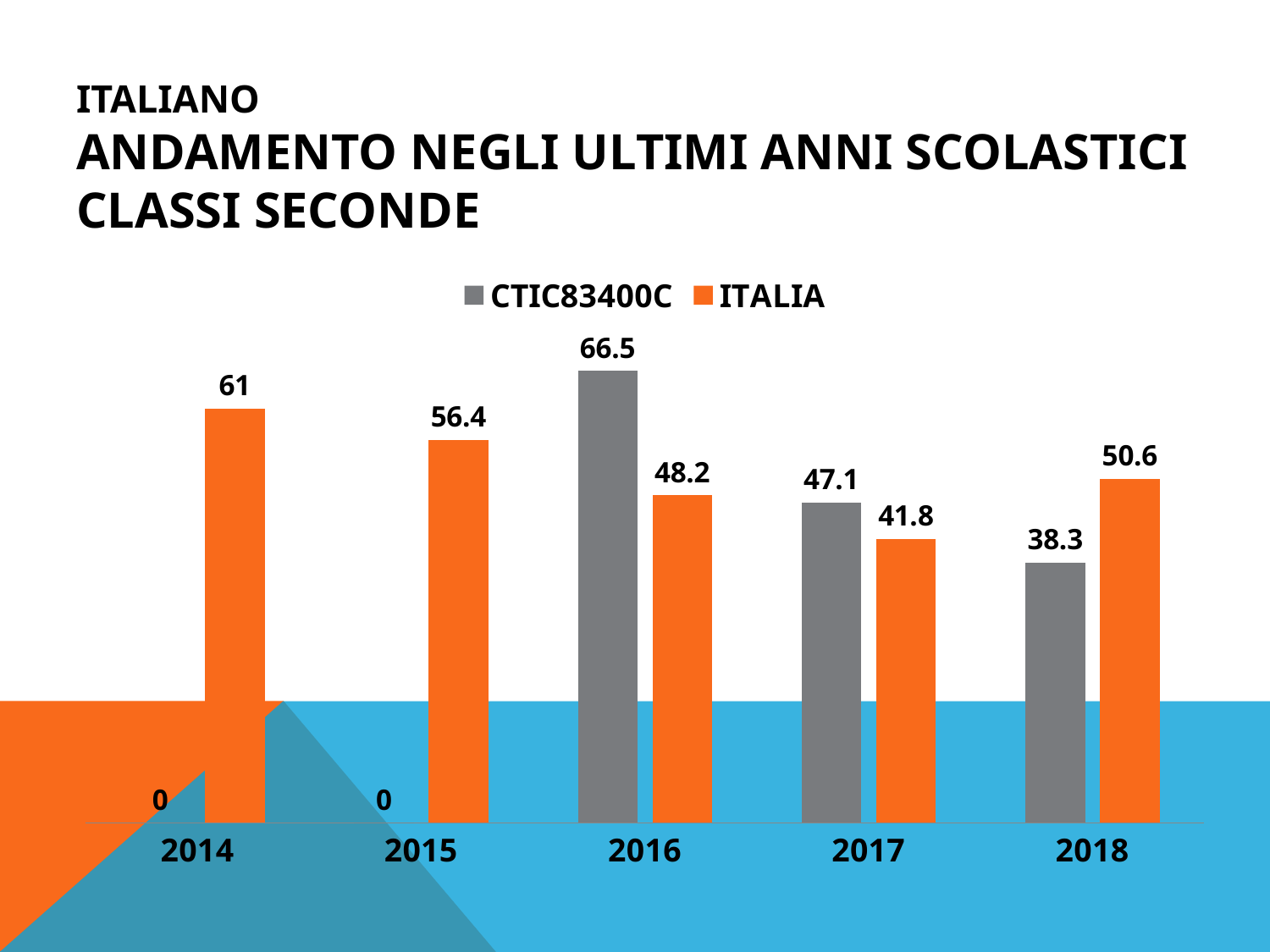
How many series does the legend list? 2 What is the value for CTIC83400C in 2016? 66.5 What is the difference between ITALIA in 2018 and CTIC83400C in 2018? 12.3 What is the value for CTIC83400C in 2014? 0 How many years are shown on the x axis? 5 In which year is the ITALIA value lowest? 2017 What kind of chart is shown on the slide? Bar chart In which year is the ITALIA value highest? 2014 What is the value for ITALIA in 2018? 50.6 What is the value for ITALIA in 2014? 61 What is the difference between CTIC83400C and ITALIA in 2016? 18.3 Which is larger in 2017, CTIC83400C or ITALIA? CTIC83400C